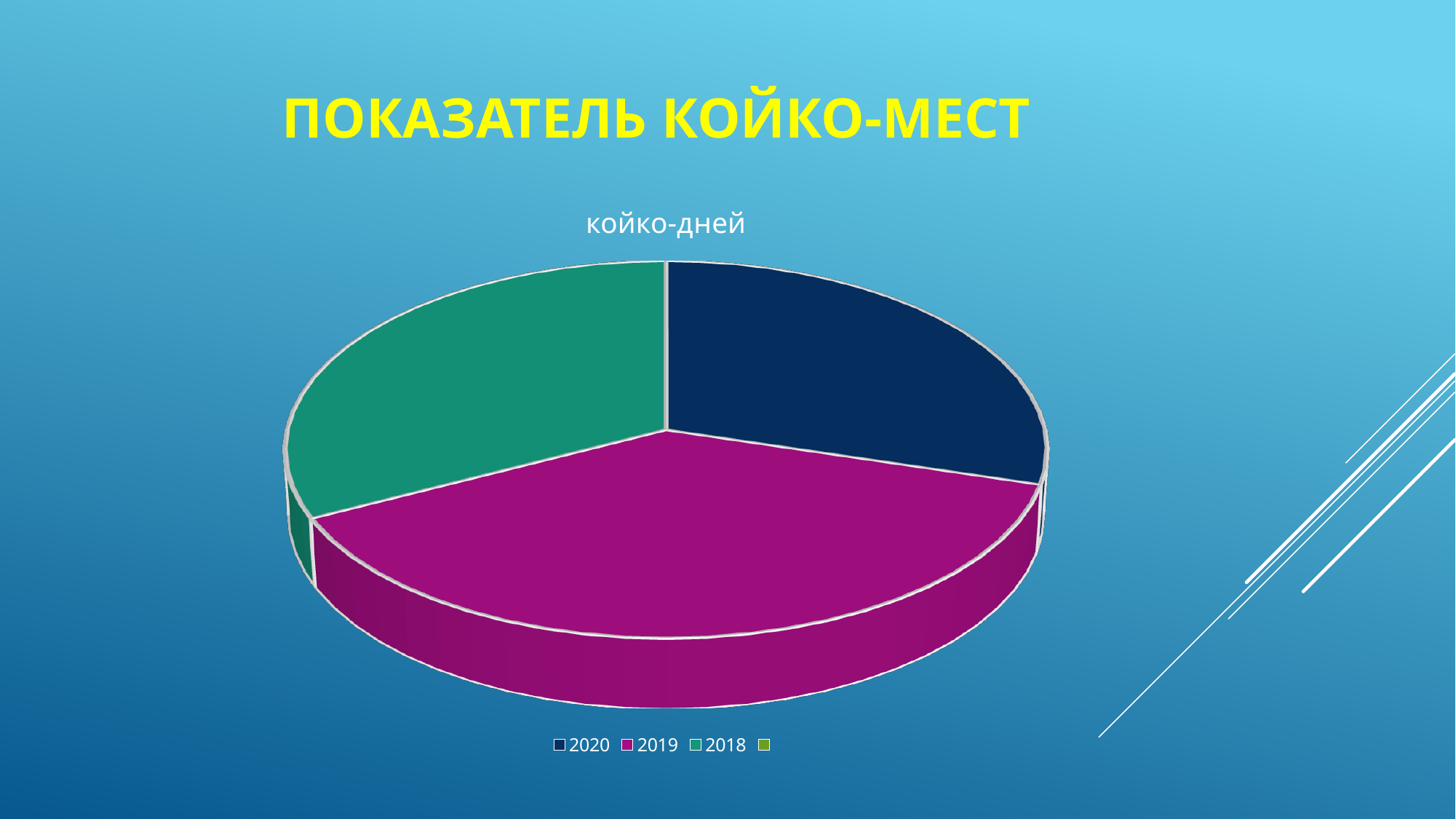
What is the title of the chart? койко-дней What kind of chart is shown on the slide? pie chart Which year has the largest slice of the pie? 2019 How many slices are visible in the pie chart? 3 Which slice is larger, 2019 or 2018? 2019 Is the 2019 slice greater or less than half of the pie? less Which years are listed in the legend? 2020, 2019, 2018 How many labeled years does the legend list? 3 Which slice is larger, 2019 or 2020? 2019